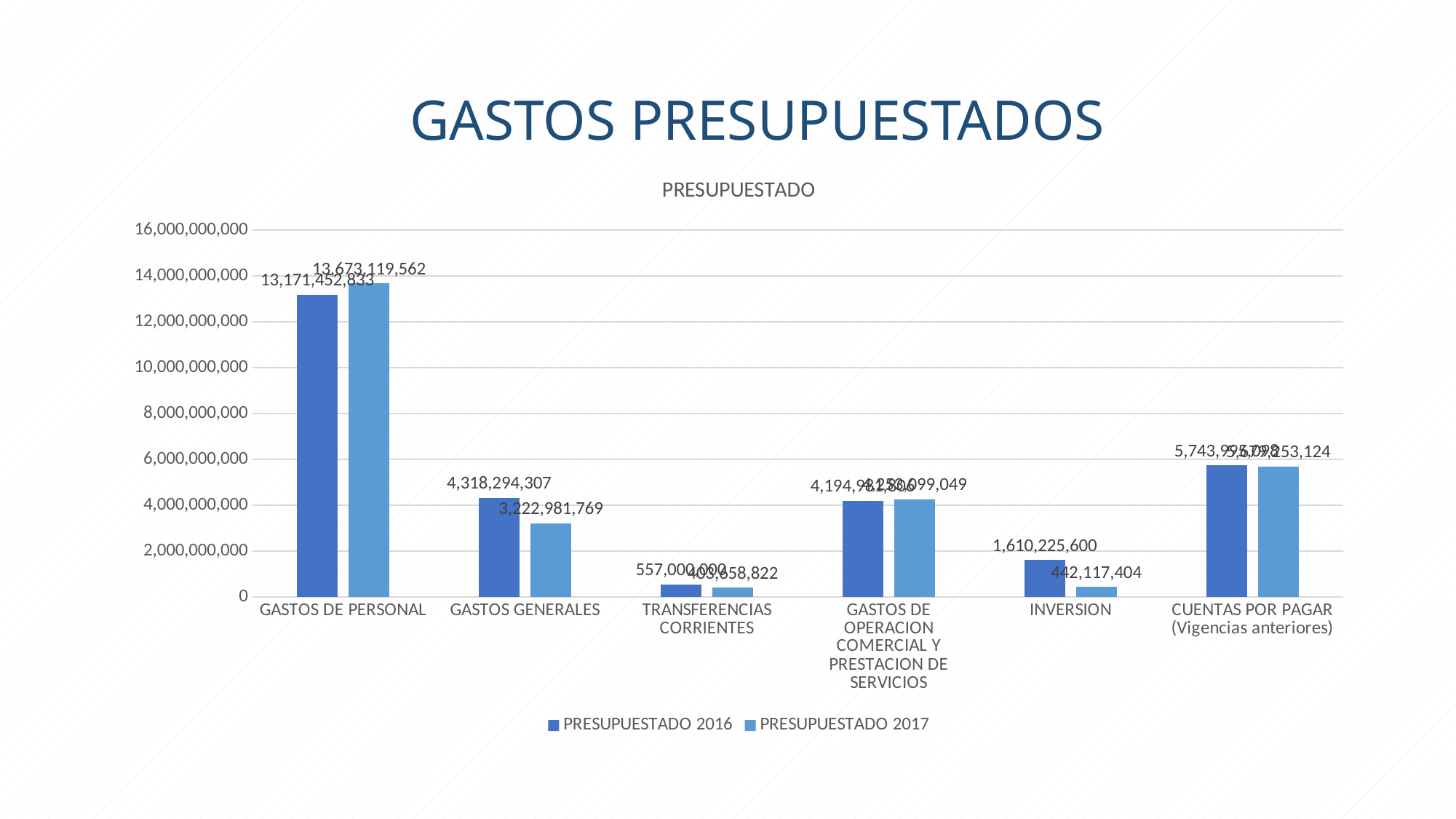
What is the difference between the PRESUPUESTADO 2017 and PRESUPUESTADO 2016 values for GASTOS DE PERSONAL? 501,666,729 How many categories are shown on the x axis? 6 What is the PRESUPUESTADO 2016 value for TRANSFERENCIAS CORRIENTES? 557,000,000 Which category has the highest PRESUPUESTADO 2016 value? GASTOS DE PERSONAL What is the PRESUPUESTADO 2017 value for INVERSION? 442,117,404 What is the PRESUPUESTADO 2016 value for GASTOS GENERALES? 4,318,294,307 Which category has the lowest PRESUPUESTADO 2016 value? TRANSFERENCIAS CORRIENTES How many series does the legend list? 2 For GASTOS GENERALES, which is larger: PRESUPUESTADO 2016 or PRESUPUESTADO 2017? PRESUPUESTADO 2016 What is the PRESUPUESTADO 2016 value for GASTOS DE PERSONAL? 13,171,452,833 What is the PRESUPUESTADO 2017 value for GASTOS DE PERSONAL? 13,673,119,562 Is the PRESUPUESTADO 2016 value for CUENTAS POR PAGAR (Vigencias anteriores) greater or less than 6,000,000,000? less